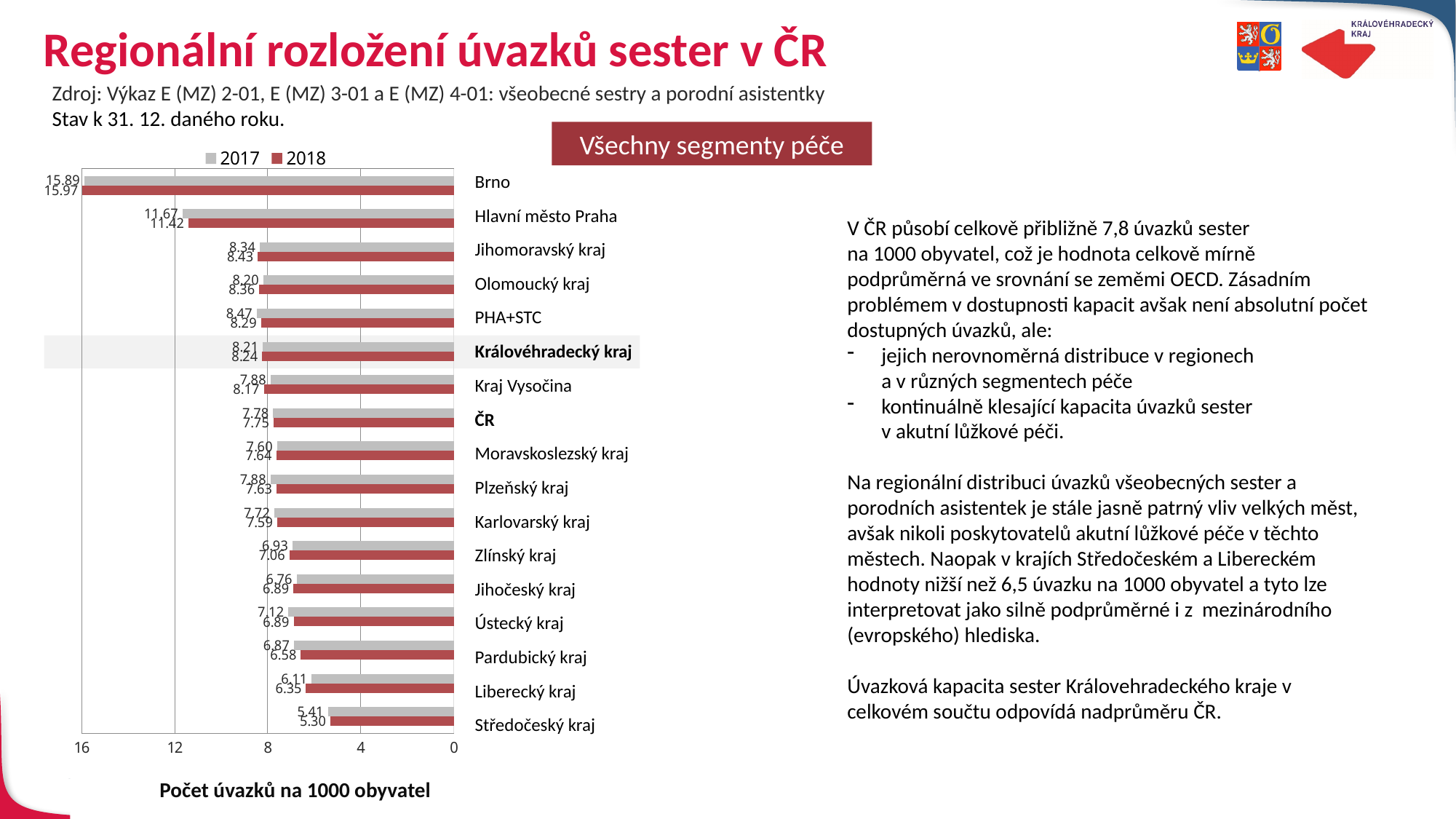
What is the 2017 value for Královéhradecký kraj? 8.21 What is the difference between the 2017 and 2018 values for Hlavní město Praha? 0.25 Which category has the lowest 2017 value? Středočeský kraj What is the label of the horizontal axis of the chart? Počet úvazků na 1000 obyvatel How many categories are shown on the chart? 17 What is the 2018 value for Středočeský kraj? 5.30 What is the 2018 value for Brno? 15.97 How many series does the legend list? 2 Which is larger for Liberecký kraj, the 2017 value or the 2018 value? 2018 Which category has the highest 2018 value? Brno What kind of chart is shown on the slide? Bar chart What is the 2017 value for ČR? 7.78